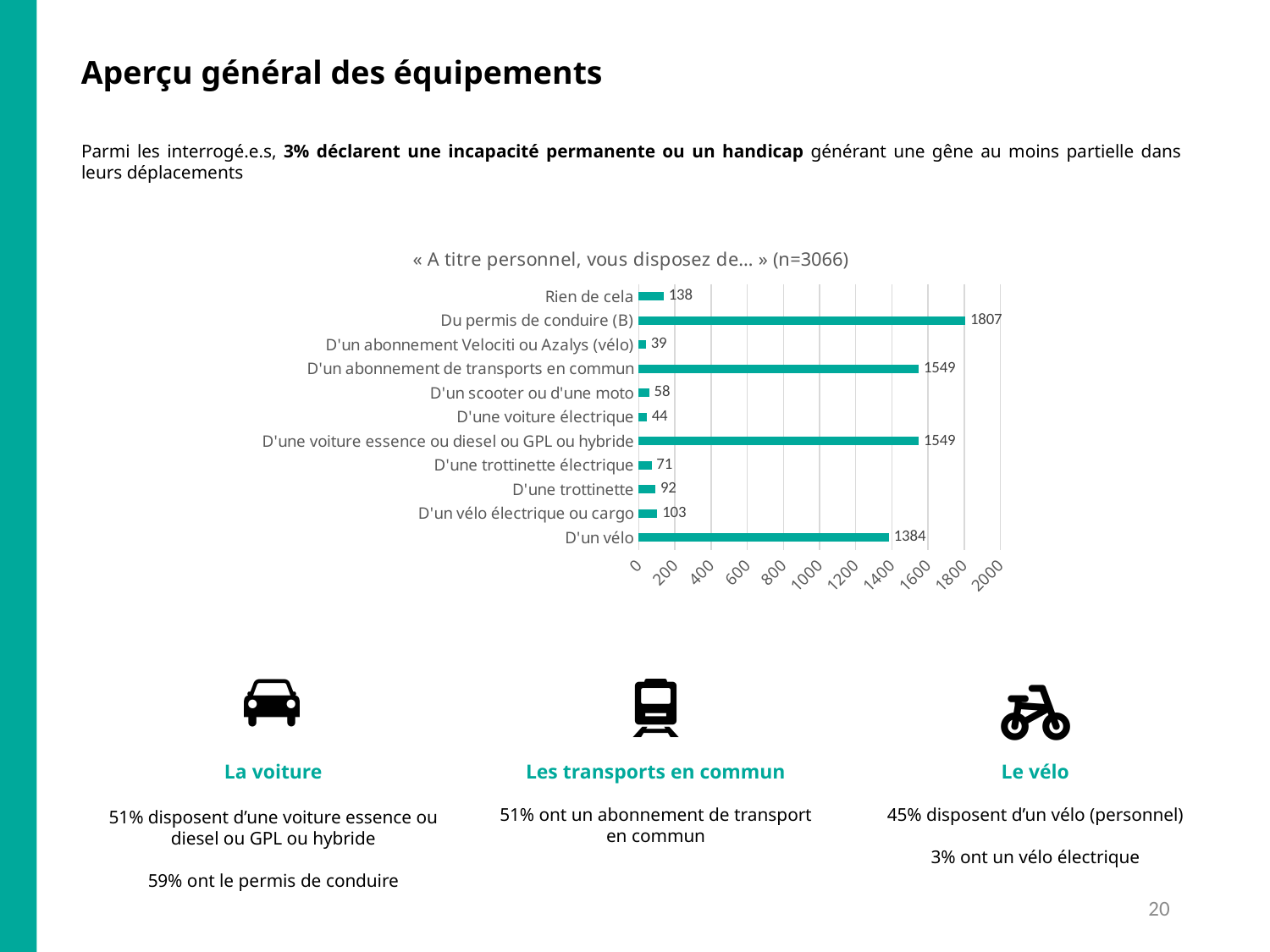
What is the difference between the values for "Du permis de conduire (B)" and "D'un abonnement de transports en commun"? 258 What kind of chart is shown on the slide? bar chart What is the value for "D'un abonnement Velociti ou Azalys (vélo)"? 39 What is the value for "Du permis de conduire (B)"? 1807 What is the value for "D'un vélo"? 1384 How many categories does the chart show? 11 Which category has the highest value? Du permis de conduire (B) Which category has the lowest value? D'un abonnement Velociti ou Azalys (vélo) What is the value for "Rien de cela"? 138 Which is larger, the value for "D'une trottinette" or for "D'une trottinette électrique"? D'une trottinette What is the sample size (n) stated in the chart title? 3066 Is the value for "D'un vélo" greater or less than 1200? greater